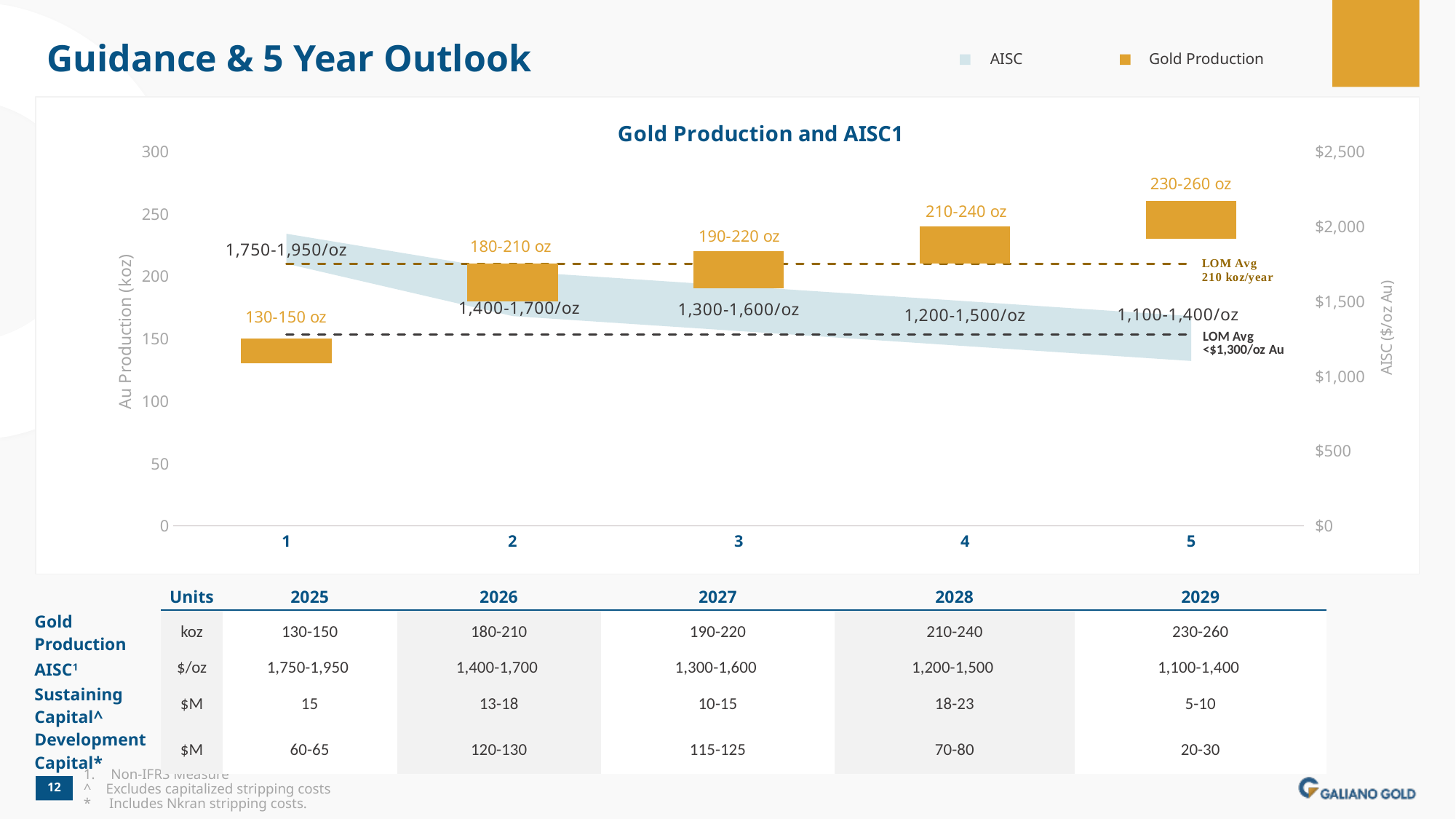
What is the title of the chart? Gold Production and AISC1 What is the AISC range labelled for year 2? 1,400-1,700/oz How many years are shown on the x axis of the chart? 5 Does the AISC range rise or fall from year 1 to year 5? fall What is the gold production range labelled for year 3? 190-220 oz Which year has the lowest gold production range? 1 What LOM average gold production is marked by the dashed line on the chart? 210 koz/year Which year has the highest gold production range? 5 What is the AISC range labelled for year 5? 1,100-1,400/oz How many series does the chart legend list? 2 Does the gold production range rise or fall from year 1 to year 5? rise What is the gold production range labelled for year 1? 130-150 oz